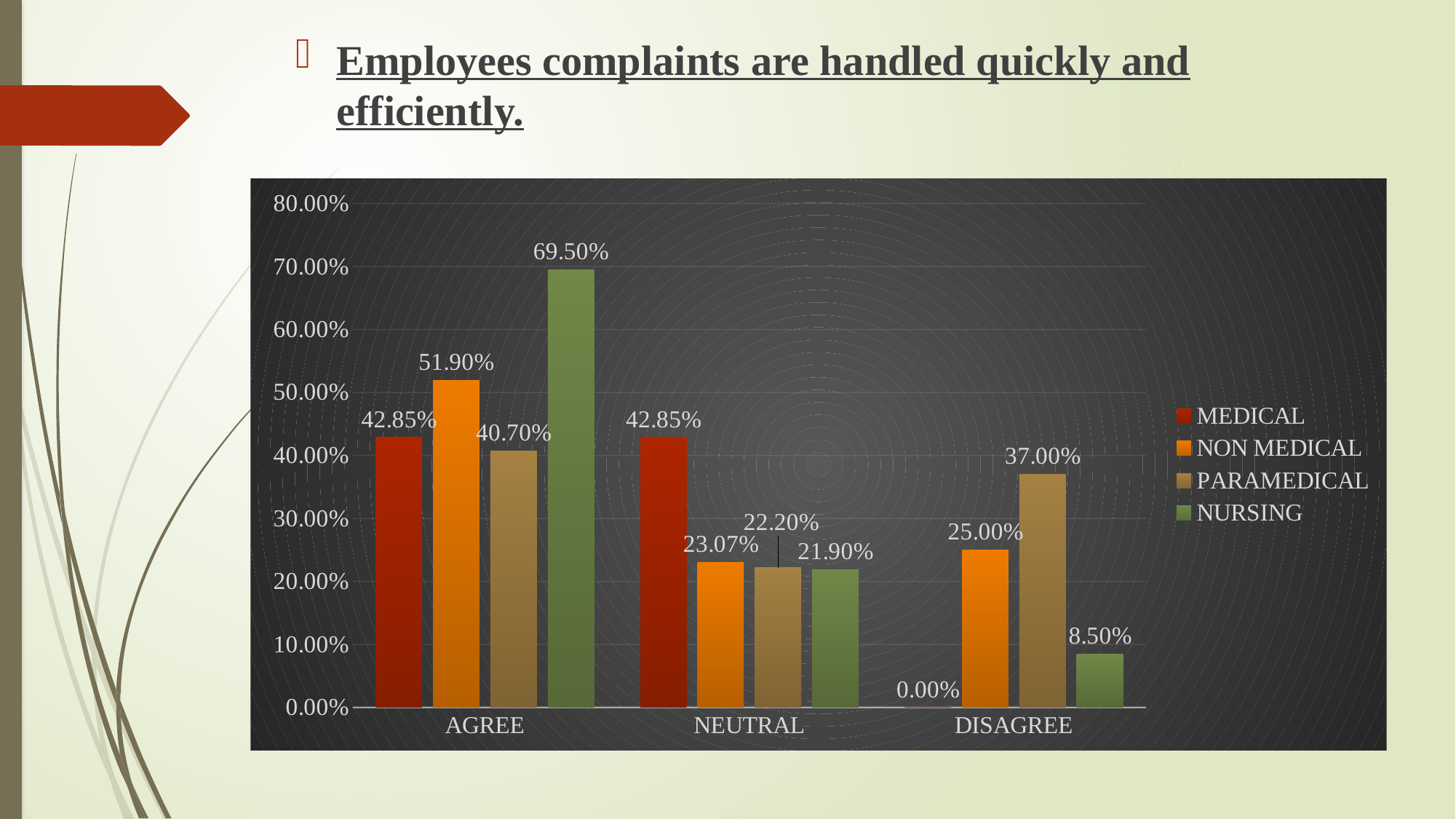
What is the value for MEDICAL in the DISAGREE category? 0.00% How many categories are shown on the x axis? 3 What is the difference between the NURSING value for AGREE and the NURSING value for DISAGREE? 61.00% Which series is shown in green in the legend? NURSING What is the value for NON MEDICAL in the DISAGREE category? 25.00% How many series does the legend list? 4 What kind of chart is shown on the slide? Bar chart Which series has the highest value in the AGREE category? NURSING What is the value for PARAMEDICAL in the NEUTRAL category? 22.20% Which series has the lowest value in the DISAGREE category? MEDICAL Which is larger: the PARAMEDICAL value for DISAGREE or the NON MEDICAL value for DISAGREE? PARAMEDICAL What is the value for NURSING in the AGREE category? 69.50%